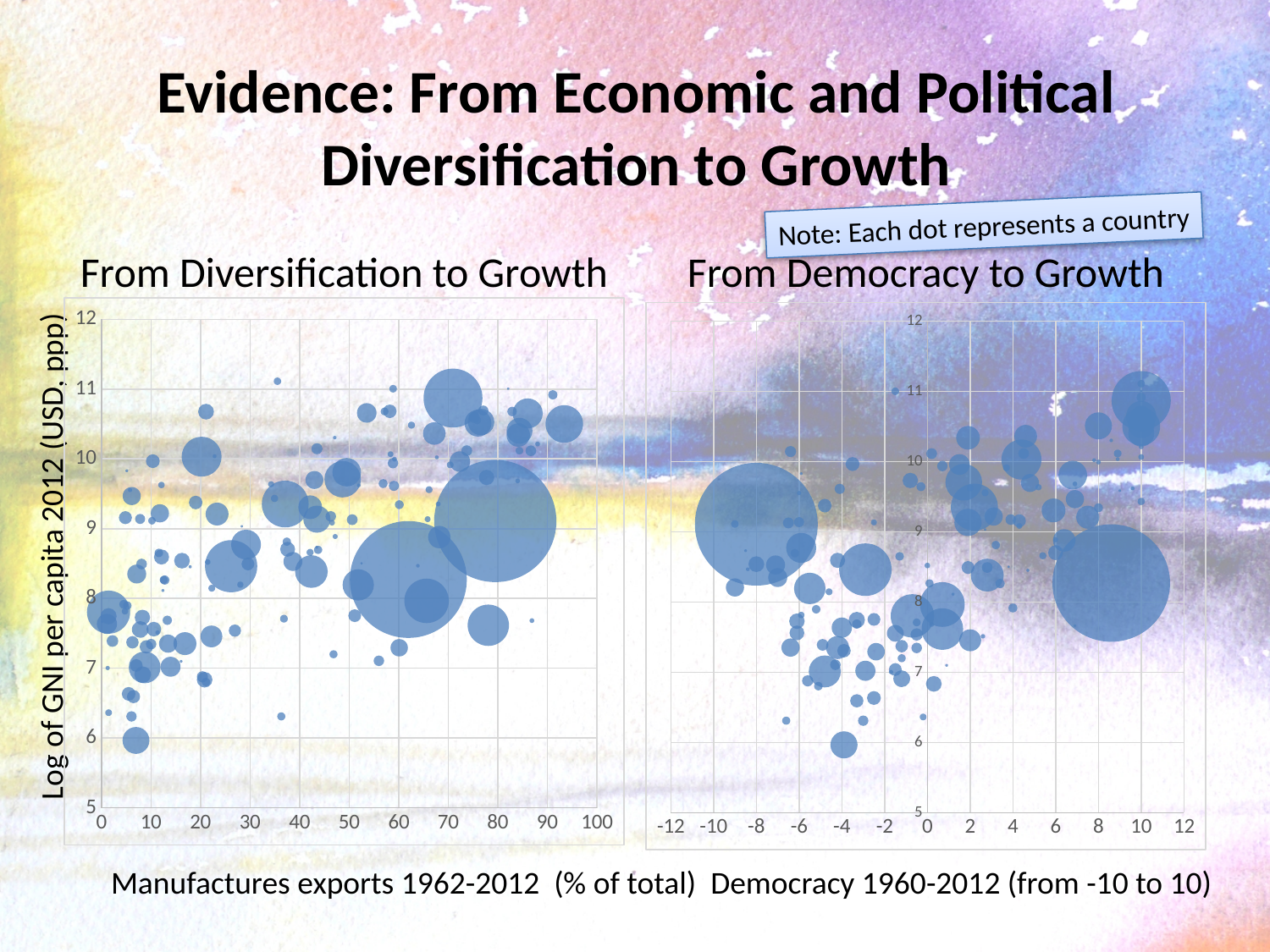
In the "From Democracy to Growth" chart, do the values of log GNI per capita generally rise or fall as the democracy score increases along the x axis? rise What kind of chart is the "From Democracy to Growth" chart on the right? bubble chart What kind of chart is the "From Diversification to Growth" chart on the left? bubble chart In the "From Diversification to Growth" chart, do the values of log GNI per capita generally rise or fall as manufactures exports increase along the x axis? rise According to the note on the slide, what does each dot in the charts represent? a country What is the label of the vertical axis shared by the two charts? Log of GNI per capita 2012 (USD, ppp) How many charts are shown on the slide? 2